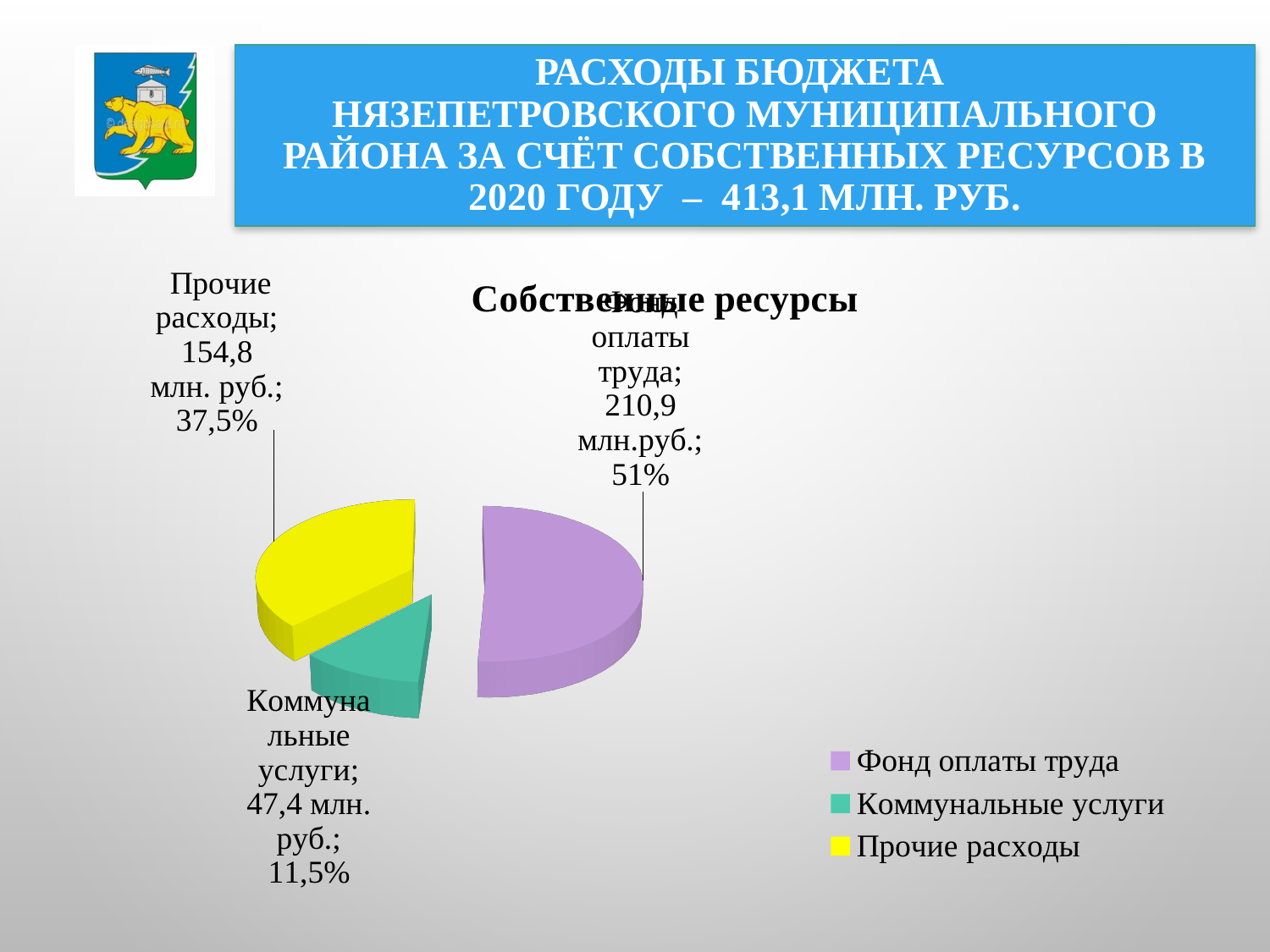
What share of the pie does Фонд оплаты труда represent? 51% How many categories are shown in the pie chart? 3 What type of chart is shown on the slide? Pie chart What share of the pie does Коммунальные услуги represent? 11,5% What is the value for Фонд оплаты труда in the pie chart? 210,9 млн.руб. Which category has the smallest slice in the pie chart? Коммунальные услуги What is the value for Прочие расходы in the pie chart? 154,8 млн. руб. What share of the pie does Прочие расходы represent? 37,5% Which category has the largest slice in the pie chart? Фонд оплаты труда What is the title of the pie chart? Собственные ресурсы Which is larger: Прочие расходы or Коммунальные услуги? Прочие расходы What is the value for Коммунальные услуги in the pie chart? 47,4 млн. руб.